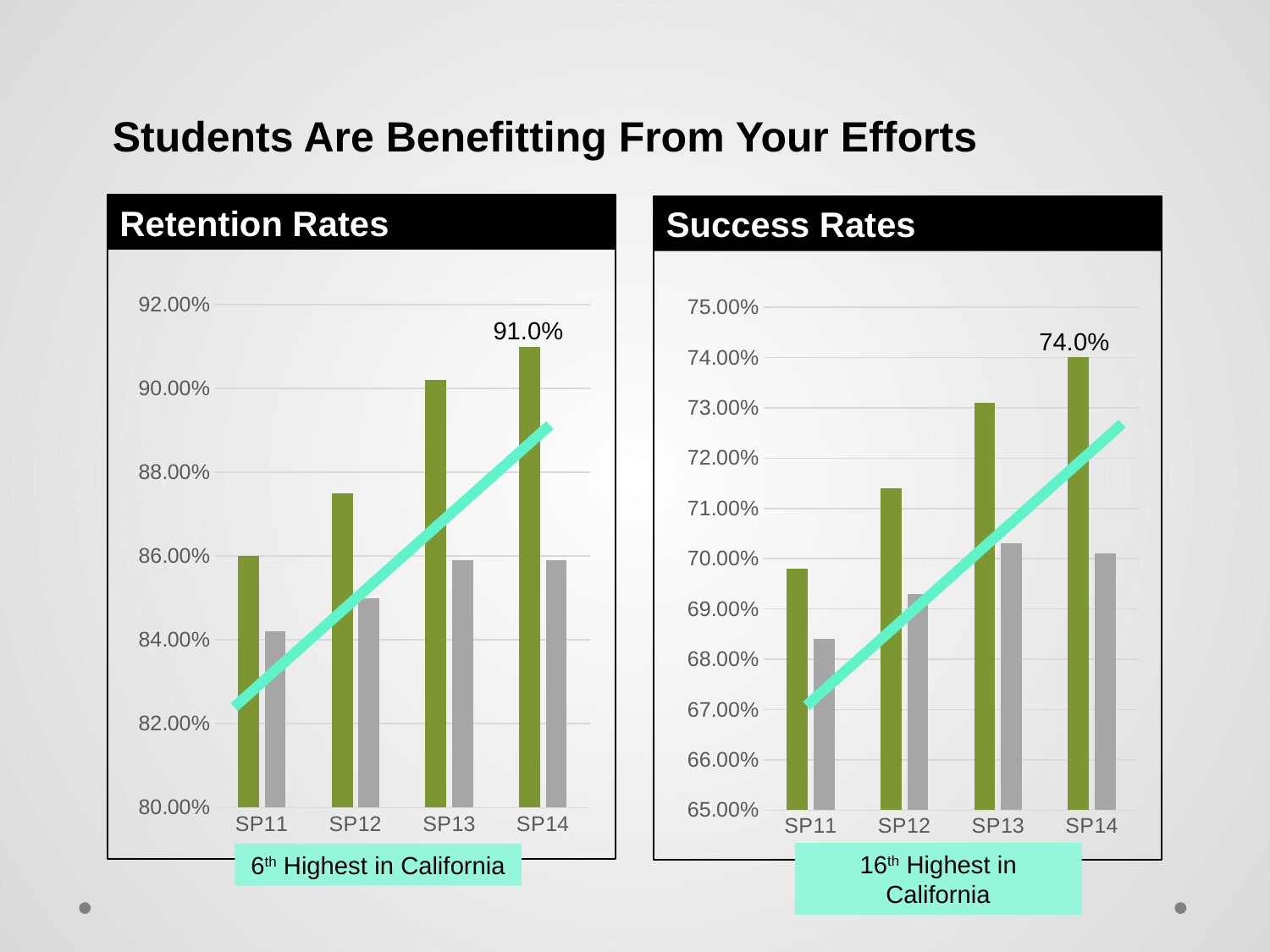
In the Success Rates chart, which semester has the shortest green bar? SP11 In the Retention Rates chart, what value is labelled on the green bar for SP14? 91.0% What is the title of the chart on the left side of the slide? Retention Rates How many semesters are shown on the x axis of the Retention Rates chart? 4 In the Success Rates chart, what value is labelled on the green bar for SP14? 74.0% In the Success Rates chart, is the green bar for SP12 greater or less than 71.00%? greater In the Retention Rates chart, which semester has the tallest green bar? SP14 In the Retention Rates chart, is the green bar for SP12 greater or less than 88.00%? less In the Success Rates chart, is the gray bar for SP11 greater or less than 69.00%? less In the Retention Rates chart, do the green bars rise or fall from SP11 to SP14? rise In the Retention Rates chart for SP13, which bar is taller, the green bar or the gray bar? the green bar What kind of chart is the Success Rates chart? bar chart